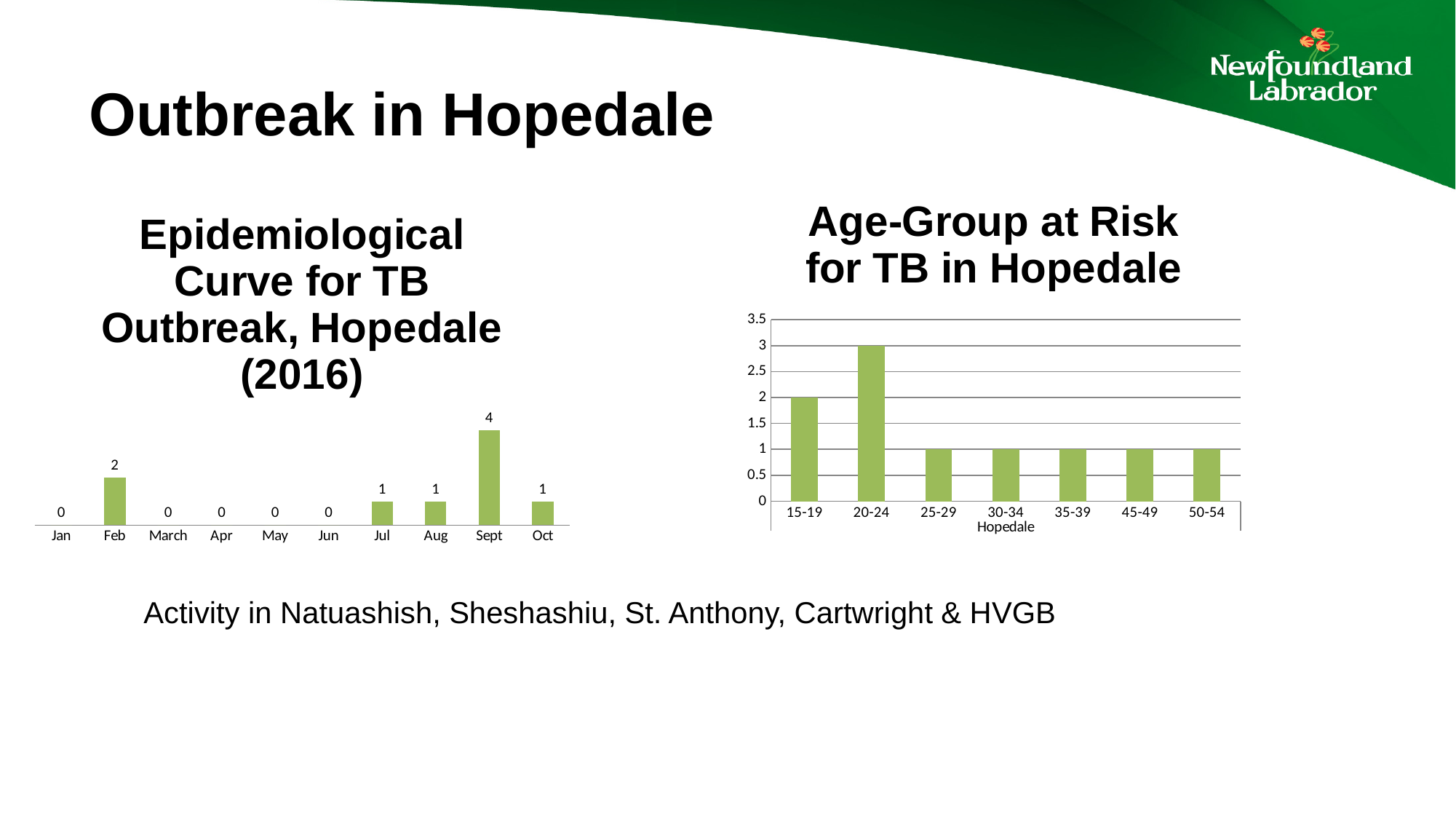
In the Age-Group at Risk chart, how many age groups are shown on the x axis? 7 In the Age-Group at Risk chart, what is the value for the 15-19 age group? 2 In the Age-Group at Risk chart, what is the value for the 20-24 age group? 3 In the Age-Group at Risk chart, is the value for 15-19 larger or smaller than the value for 25-29? larger In the Epidemiological Curve chart, how many months have a value of 0? 5 In the Age-Group at Risk chart, which age group has the highest value? 20-24 In the Epidemiological Curve chart, what is the difference between the values for Sept and Feb? 2 In the Epidemiological Curve chart, what is the value for Sept? 4 In the Epidemiological Curve chart, which month has the highest value? Sept What kind of chart is the Age-Group at Risk chart? bar chart In the Epidemiological Curve chart, how many months are shown on the x axis? 10 In the Epidemiological Curve chart, what is the value for Feb? 2